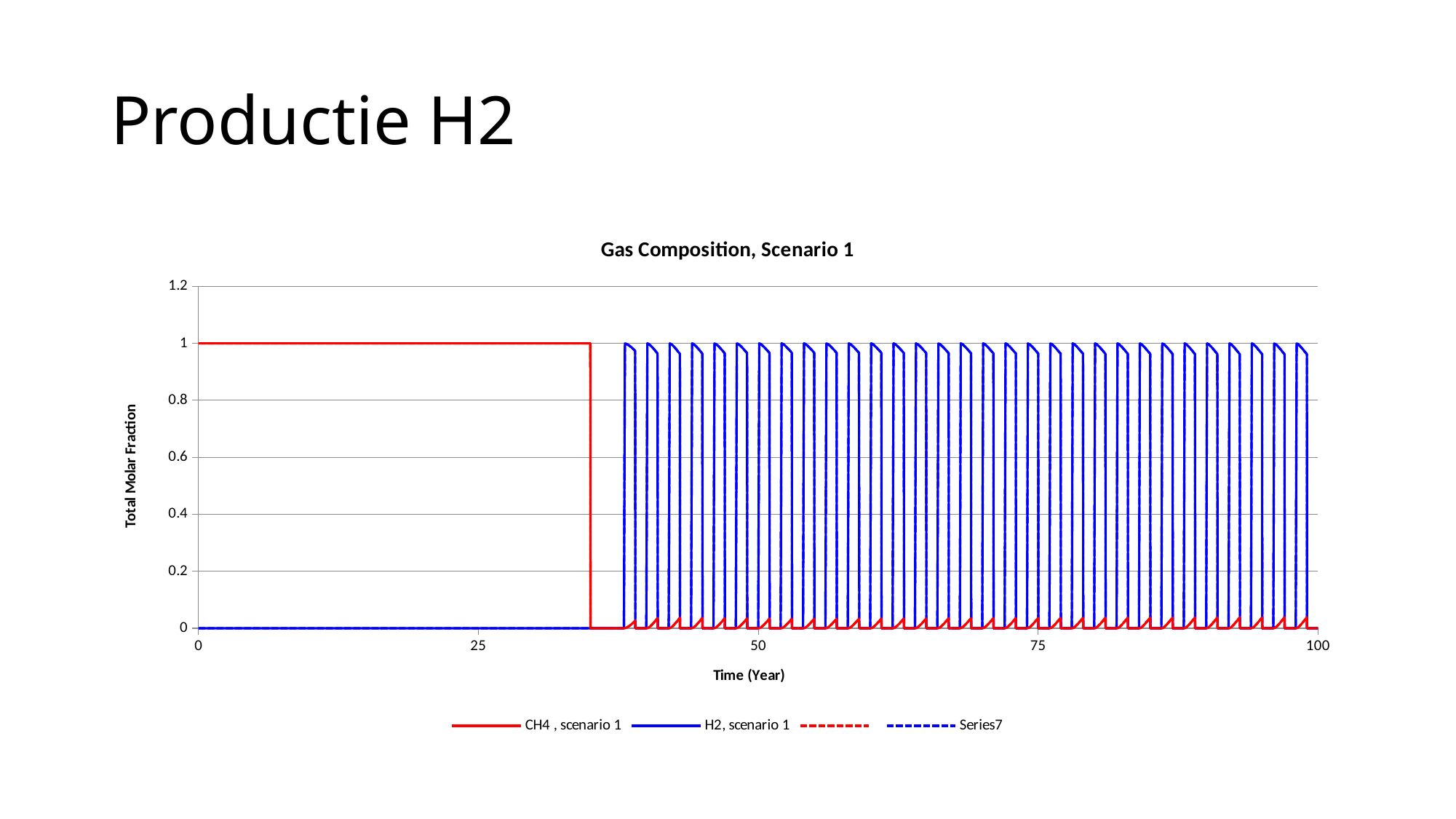
What is the value of H2, scenario 1 at year 25? 0 Does the CH4, scenario 1 line rise or fall over the time axis? fall What is the value of CH4, scenario 1 at year 10? 1 How many entries does the legend show? 4 At year 25, which is larger, CH4, scenario 1 or H2, scenario 1? CH4, scenario 1 What is the highest tick value shown on the y axis? 1.2 Are the values of CH4, scenario 1 after year 40 greater or less than 0.2? less What kind of chart is shown on the slide? line chart After year 50, which series reaches the higher values, CH4, scenario 1 or H2, scenario 1? H2, scenario 1 What is the title of the chart? Gas Composition, Scenario 1 Are the peak values of H2, scenario 1 after year 40 greater or less than 0.8? greater What colour is the line for H2, scenario 1? blue